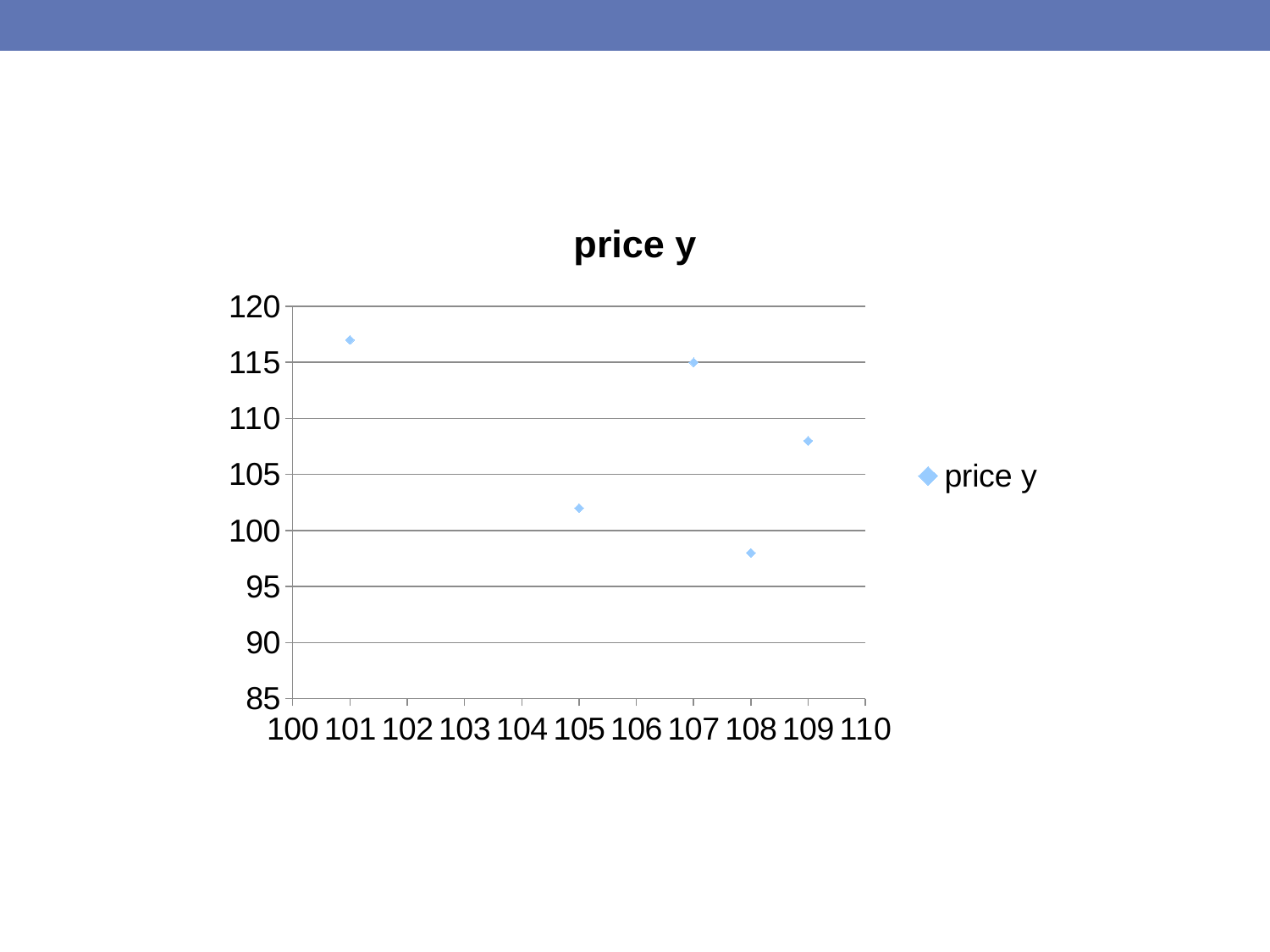
At which x value is the plotted point lowest? 108 At which x value is the plotted point highest? 101 What is the title of the chart? price y Is the value for x = 108 greater or less than 100? less How many series does the legend list? 1 Which has the larger value, the point at x = 108 or the point at x = 109? 109 Is the value for x = 109 greater or less than 105? greater Is the value for x = 101 greater or less than 115? greater What kind of chart is shown on the slide? scatter chart Which has the larger value, the point at x = 105 or the point at x = 107? 107 How many data points are plotted on the chart? 5